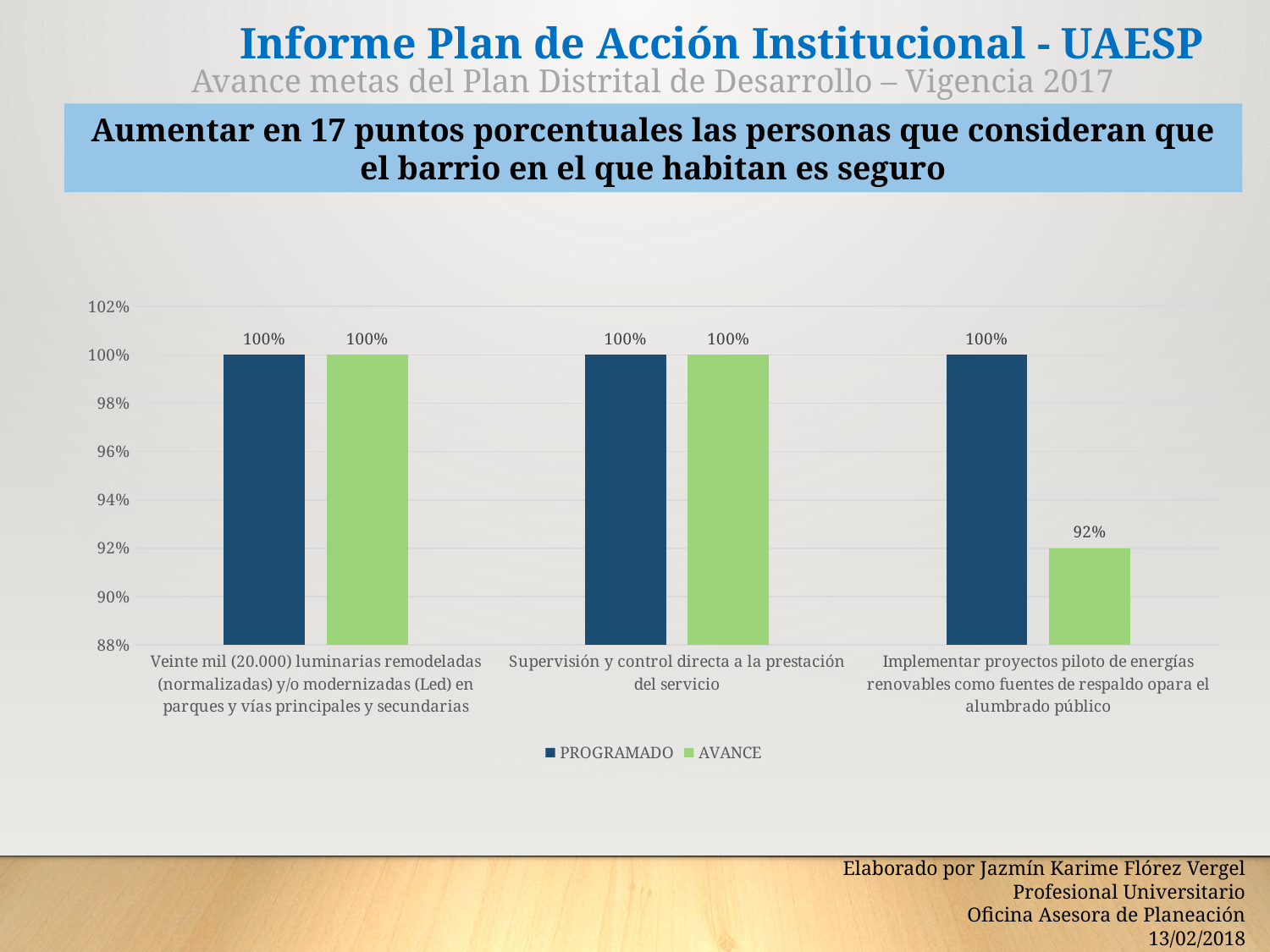
What is the AVANCE value for "Veinte mil (20.000) luminarias remodeladas (normalizadas) y/o modernizadas (Led) en parques y vías principales y secundarias"? 100% What colour are the AVANCE bars? Green What kind of chart is shown on the slide? Bar chart For "Implementar proyectos piloto de energías renovables como fuentes de respaldo opara el alumbrado público", which is larger, PROGRAMADO or AVANCE? PROGRAMADO What is the PROGRAMADO value for "Supervisión y control directa a la prestación del servicio"? 100% How many categories are shown on the x axis of the chart? 3 Is the AVANCE value for "Implementar proyectos piloto de energías renovables como fuentes de respaldo opara el alumbrado público" greater or less than 94%? less What is the AVANCE value for "Implementar proyectos piloto de energías renovables como fuentes de respaldo opara el alumbrado público"? 92% What are the two series named in the legend? PROGRAMADO and AVANCE Which category has the lowest AVANCE value? Implementar proyectos piloto de energías renovables como fuentes de respaldo opara el alumbrado público How many series does the legend list? 2 What is the difference between the PROGRAMADO and AVANCE values for "Implementar proyectos piloto de energías renovables como fuentes de respaldo opara el alumbrado público"? 8%